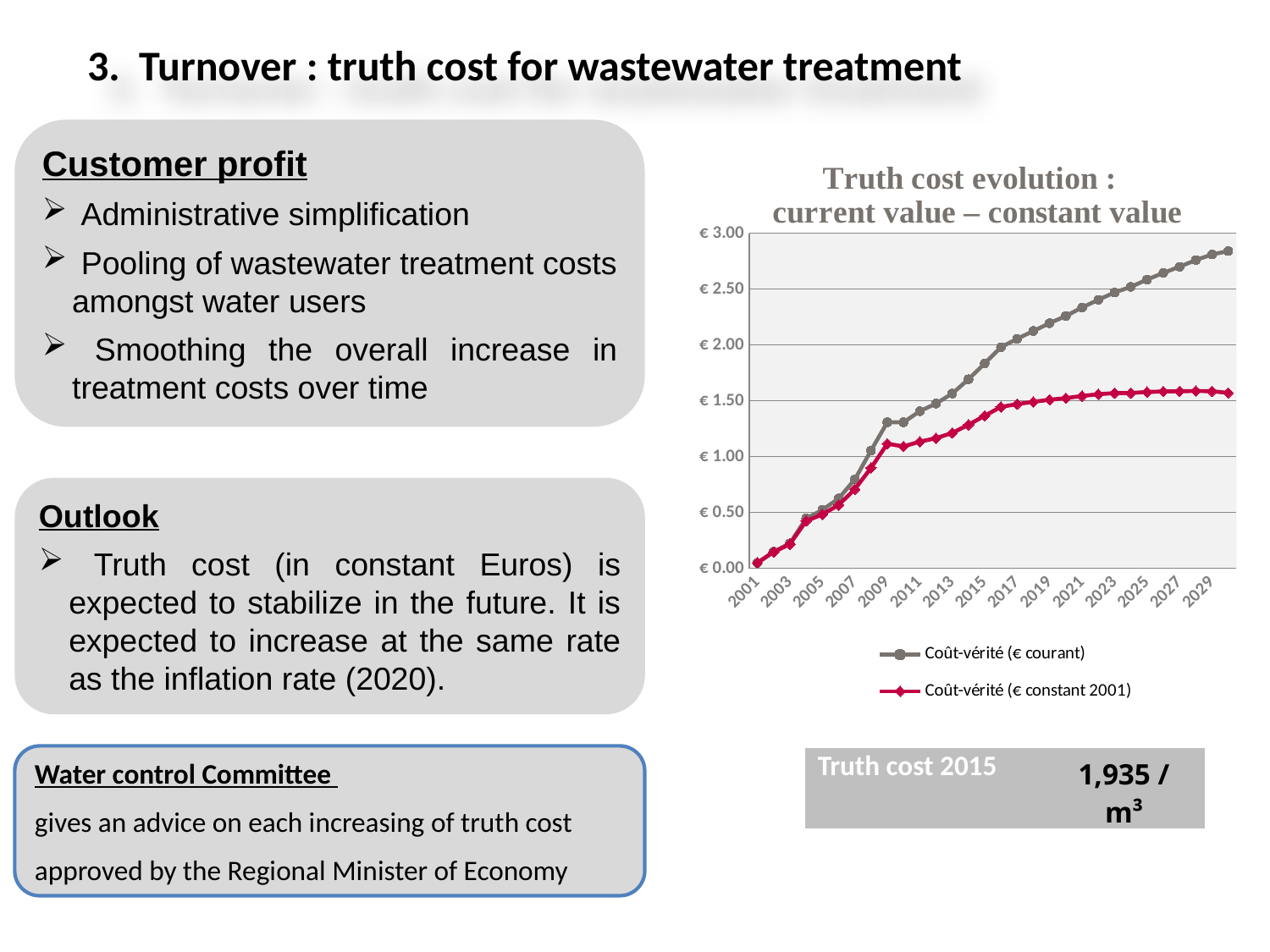
In 2029, which series has the higher value, Coût-vérité (€ courant) or Coût-vérité (€ constant 2001)? Coût-vérité (€ courant) Between 2021 and 2029, does the Coût-vérité (€ constant 2001) series keep rising steeply or stay roughly flat? roughly flat Is the value of Coût-vérité (€ courant) in 2029 greater or less than € 2.50? greater What is the last year shown on the x axis of the chart? 2029 How many series does the chart legend list? 2 What is the title of the chart? Truth cost evolution : current value – constant value Does the Coût-vérité (€ courant) series rise or fall from 2001 to 2029? rise Is the value of Coût-vérité (€ constant 2001) in 2029 greater or less than € 2.00? less Is the value of Coût-vérité (€ courant) in 2001 greater or less than € 0.50? less What kind of chart is shown on the slide? line chart Which series is drawn in red with diamond markers? Coût-vérité (€ constant 2001)